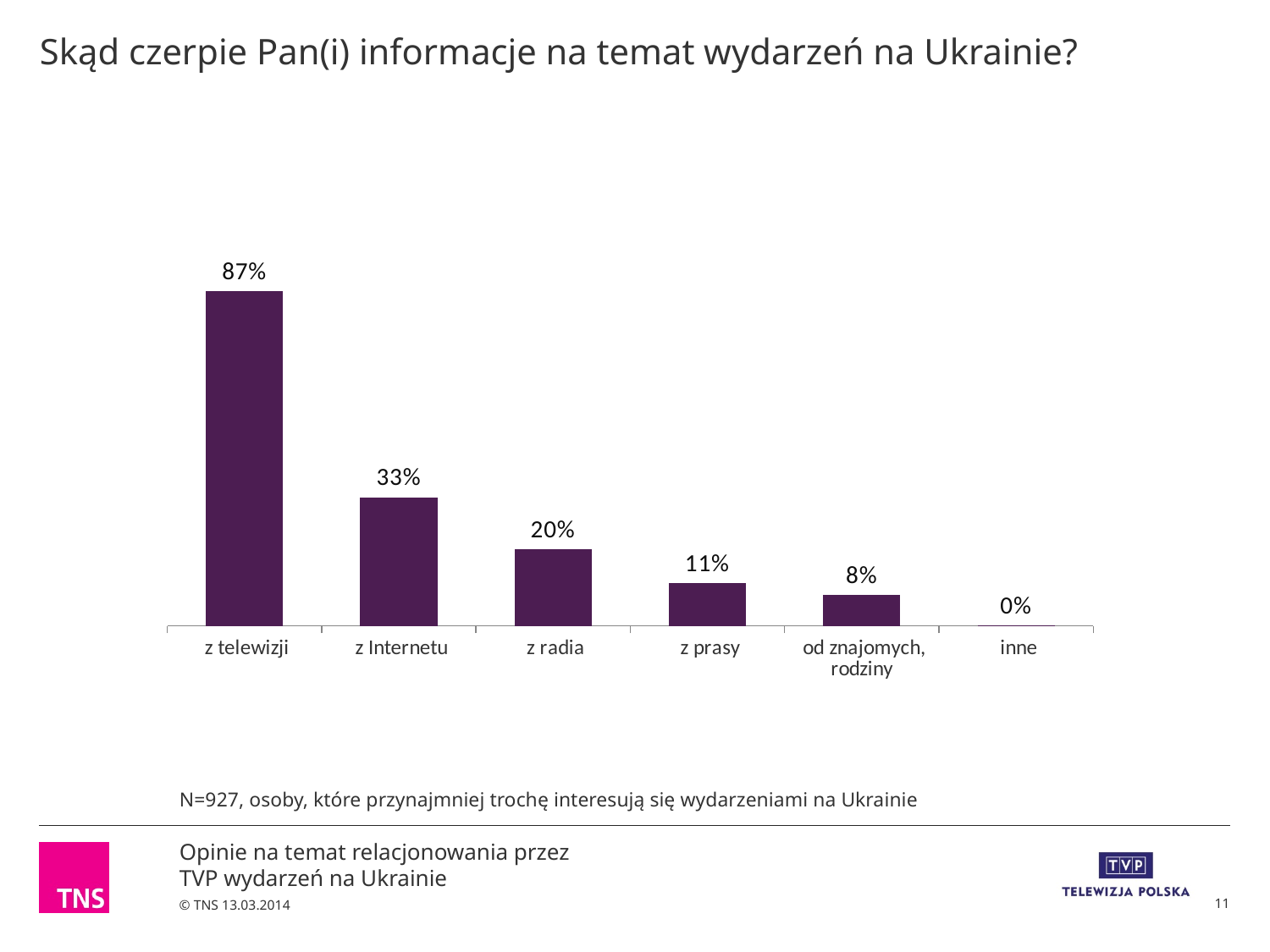
What is the difference between the values for 'z telewizji' and 'z Internetu'? 54 percentage points What is the value shown for 'z radia'? 20% What is the value shown for 'od znajomych, rodziny'? 8% What is the value shown for 'z Internetu'? 33% What percentage of respondents get information about events in Ukraine from television (z telewizji)? 87% How many categories are shown in the chart? 6 What is the difference between the values for 'z radia' and 'z prasy'? 9 percentage points Which source has the highest value in the chart? z telewizji Do the values rise or fall from left to right across the categories? Fall Which is larger, the value for 'z prasy' or the value for 'od znajomych, rodziny'? z prasy Which category has the lowest value in the chart? inne What kind of chart is shown on the slide? Bar chart